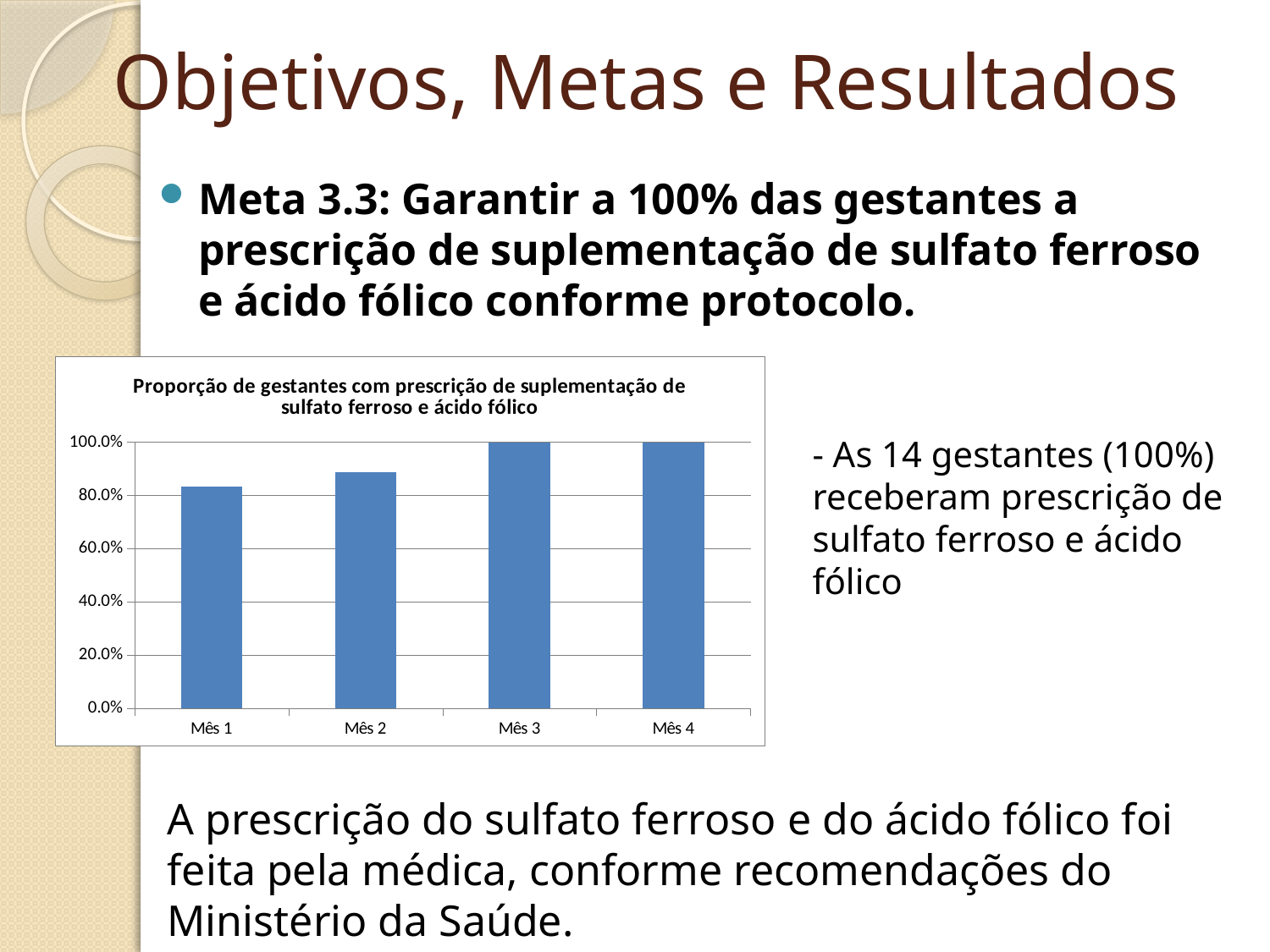
What is the value for Mês 3? 100.0% What kind of chart is shown on the slide? bar chart Is the value for Mês 2 greater or less than 100.0%? less How many categories (months) are plotted on the chart? 4 What is the value for Mês 4? 100.0% What is the title of the chart? Proporção de gestantes com prescrição de suplementação de sulfato ferroso e ácido fólico Is the value for Mês 1 greater or less than 100.0%? less Is the value for Mês 1 greater or less than 80.0%? greater Do the values rise or fall from Mês 1 to Mês 4? rise Which is larger, the value for Mês 1 or the value for Mês 2? Mês 2 Which is larger, the value for Mês 2 or the value for Mês 3? Mês 3 Which month has the lowest value? Mês 1